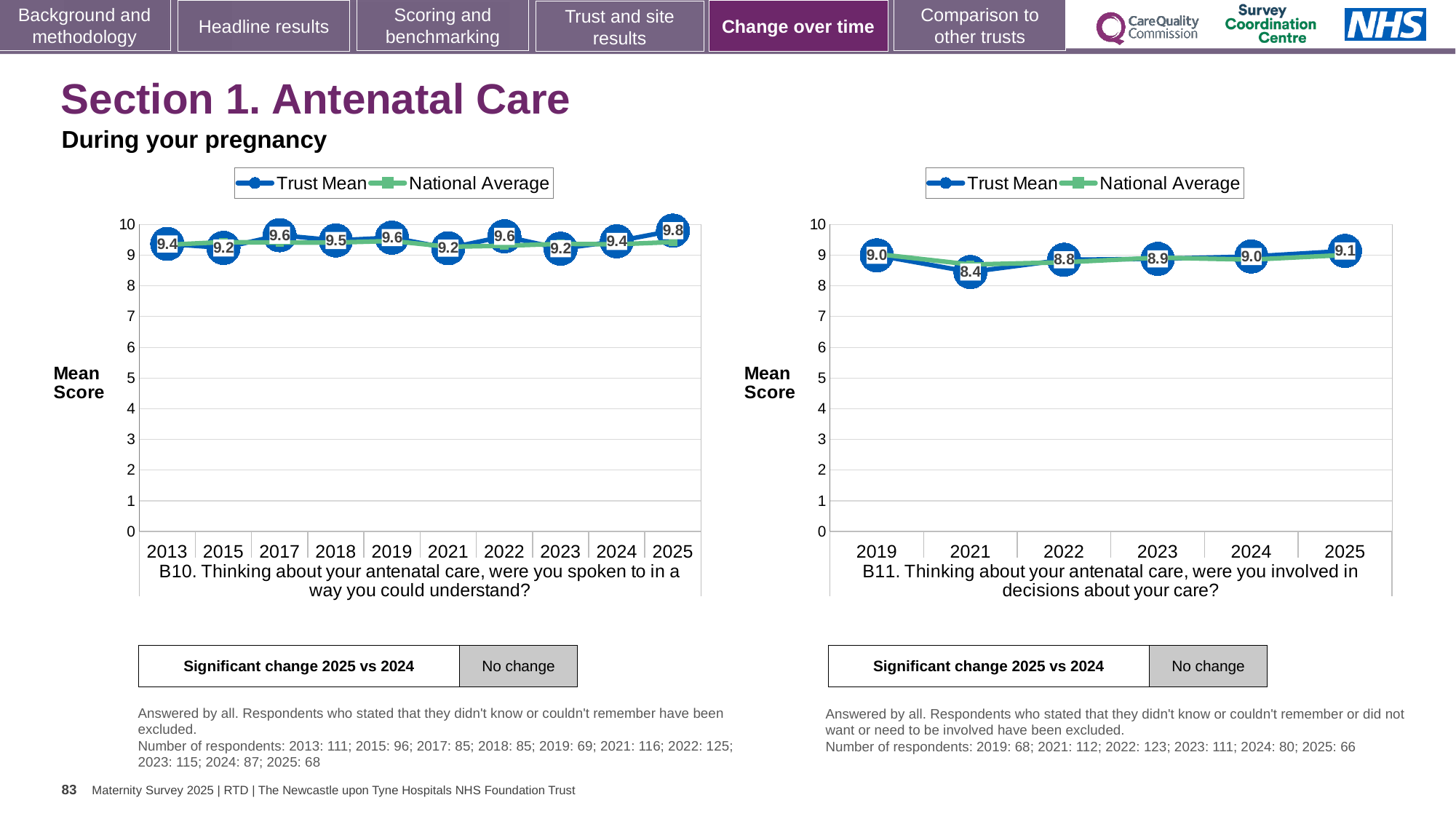
How many years are shown on the x axis of the B10 chart on the left? 10 How many series does the legend of the B11 chart on the right list? 2 In the B11 chart on the right, what is the Trust Mean for 2021? 8.4 In the B11 chart on the right, does the Trust Mean rise or fall from 2021 to 2025? Rise In the B11 chart on the right, is the Trust Mean for 2019 or 2021 larger? 2019 In the B10 chart on the left, what is the Trust Mean for 2013? 9.4 In the B11 chart on the right, which year has the lowest Trust Mean? 2021 In the B10 chart on the left, which year has the highest Trust Mean? 2025 In the B10 chart on the left, what is the Trust Mean for 2025? 9.8 In the B11 chart on the right, what is the difference between the Trust Mean for 2025 and 2021? 0.7 In the B10 chart on the left, what is the difference between the Trust Mean for 2025 and 2024? 0.4 What kind of chart is the B11 chart on the right? Line chart